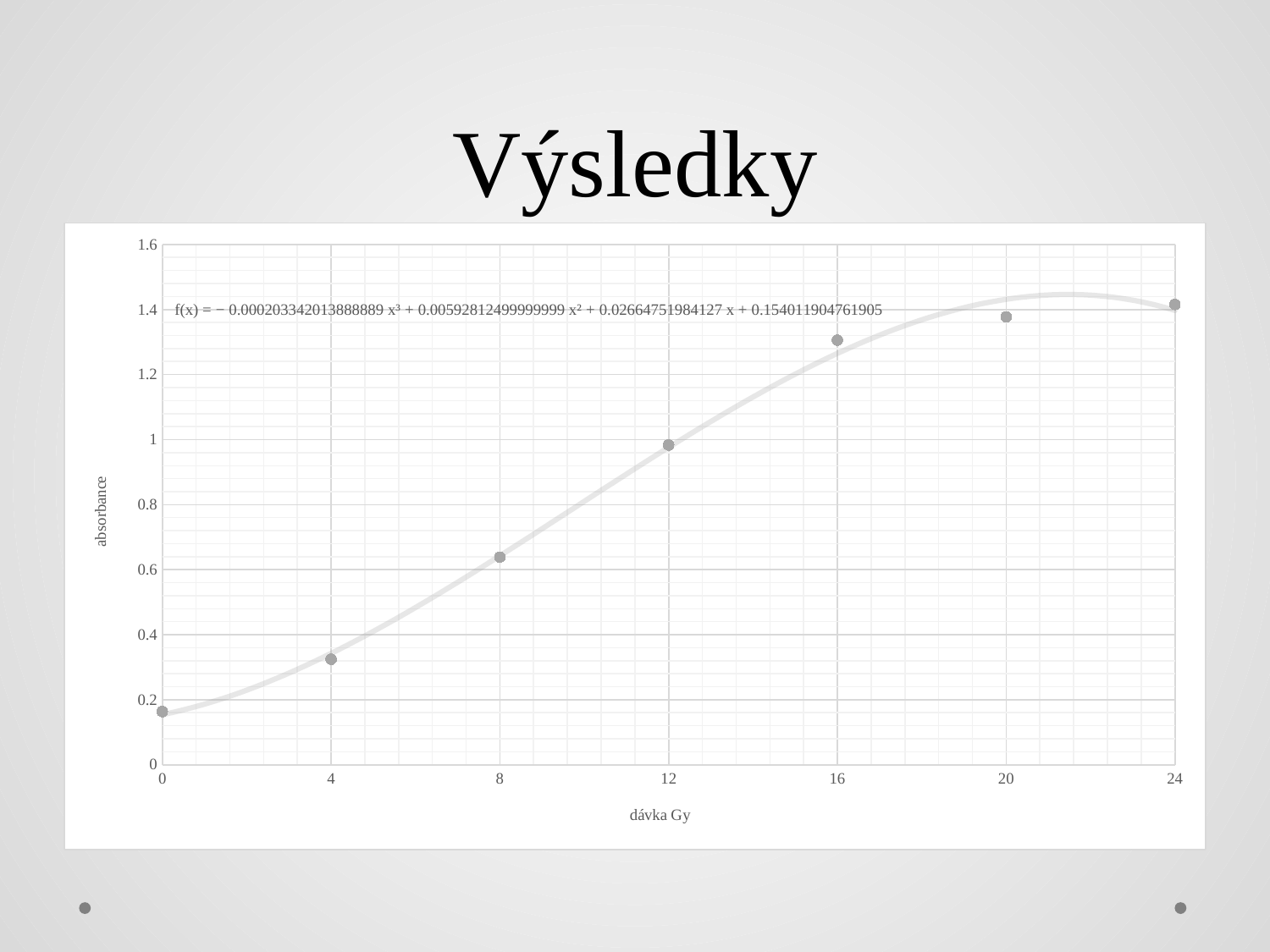
Is the absorbance at a dose of 4 Gy greater or less than 0.4? less Is the absorbance at a dose of 12 Gy greater or less than 0.8? greater What is the label of the y axis? absorbance What kind of chart is shown on the slide? scatter chart How many data points are plotted on the chart? 7 At which dose (dávka Gy) is the absorbance lowest? 0 What is the label of the x axis? dávka Gy Is the absorbance at a dose of 0 Gy greater or less than 0.2? less Which has the higher absorbance: the point at 8 Gy or the point at 12 Gy? 12 Gy Do the absorbance values generally rise or fall as the dose (dávka Gy) increases? rise